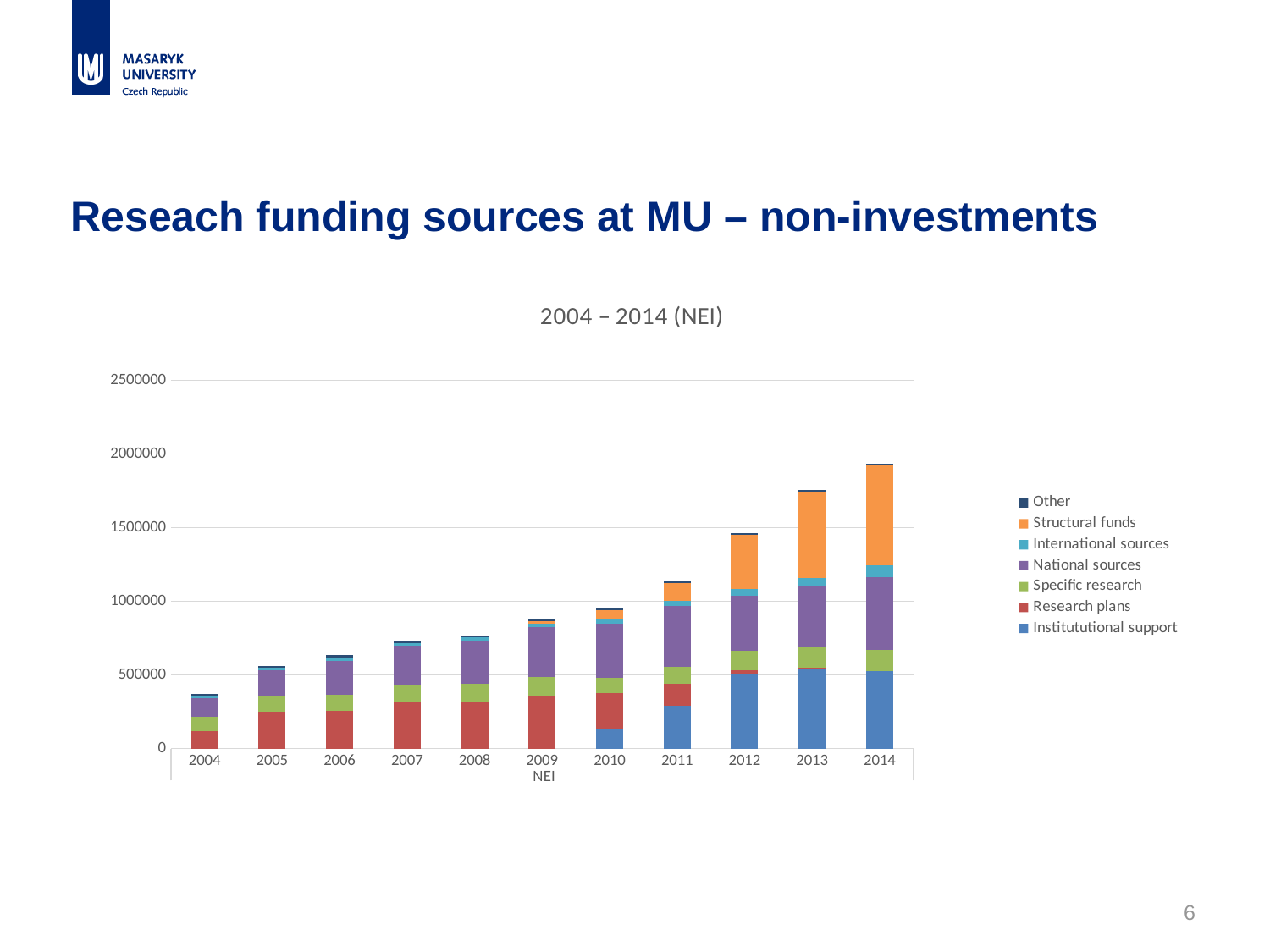
What kind of chart is shown on the slide? Stacked bar chart Which year has the larger total bar, 2012 or 2013? 2013 How many series does the chart's legend list? 7 Which year has the lowest total bar in the chart? 2004 How many years are shown on the x axis of the chart? 11 Which year has the highest total bar in the chart? 2014 Is the total bar for 2014 greater or less than 1500000? greater Is the total bar for 2008 greater or less than 500000? greater What is the title shown above the chart? 2004 – 2014 (NEI) Which series is shown in orange in the chart's legend? Structural funds Do the total bar heights generally rise or fall from 2004 to 2014? Rise Is the total bar for 2004 greater or less than 500000? less